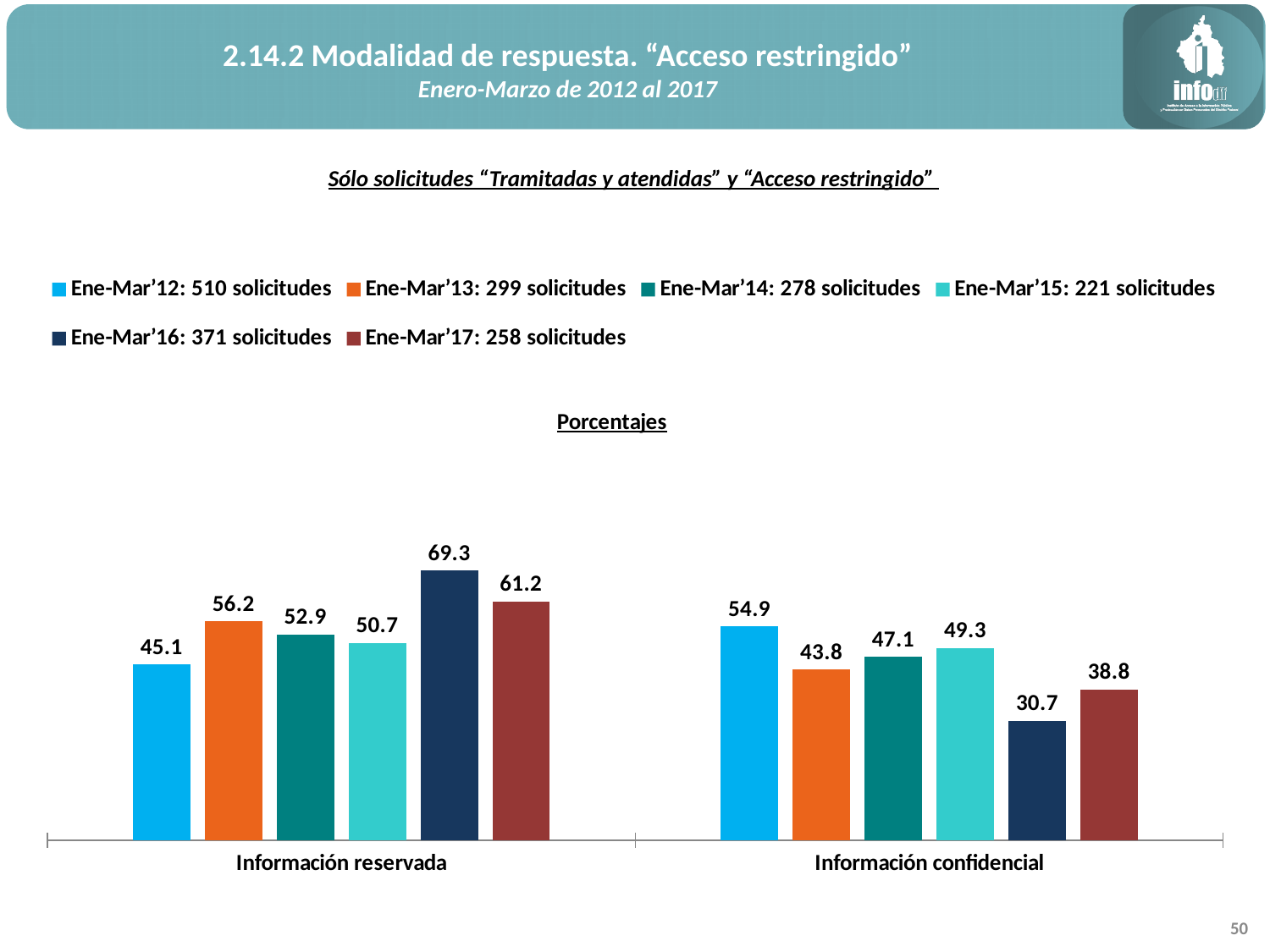
What is the value for Ene-Mar'13 in the Información confidencial category? 43.8 What is the value for Ene-Mar'16 in the Información reservada category? 69.3 Which series has the lowest value in the Información confidencial category? Ene-Mar'16: 371 solicitudes Which is larger: the Ene-Mar'17 value for Información reservada or the Ene-Mar'17 value for Información confidencial? Información reservada Which series has the lowest value in the Información reservada category? Ene-Mar'12: 510 solicitudes What kind of chart is shown on the slide? Bar chart What is the difference between the Ene-Mar'16 and Ene-Mar'12 values in the Información reservada category? 24.2 What is the value for Ene-Mar'12 in the Información reservada category? 45.1 Which series has the highest value in the Información confidencial category? Ene-Mar'12: 510 solicitudes How many series does the legend list? 6 What is the difference between the Ene-Mar'12 and Ene-Mar'16 values in the Información confidencial category? 24.2 How many categories are shown on the x axis? 2